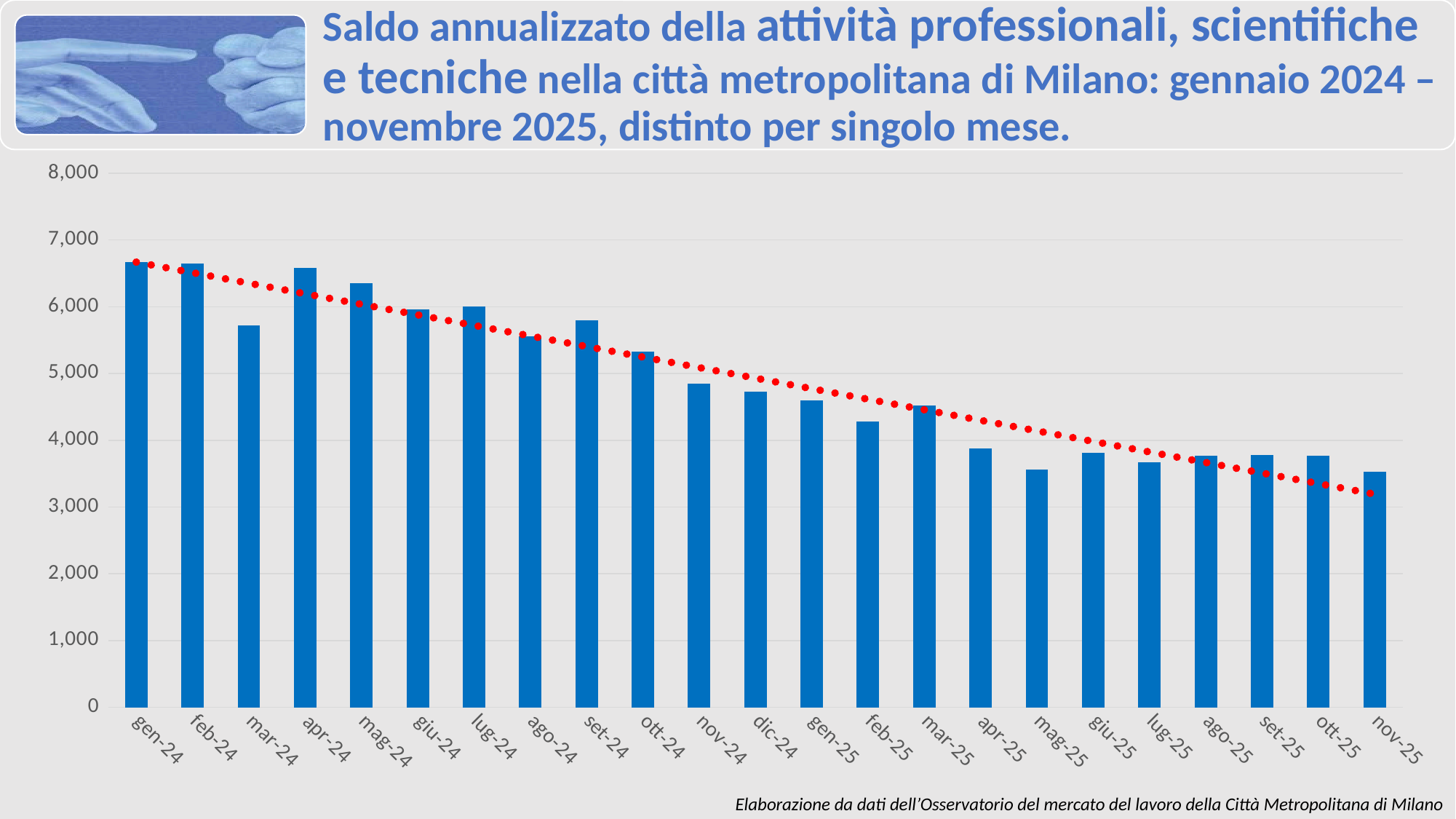
Which has the larger value, mar-24 or apr-24? apr-24 Is the value for apr-25 greater or less than 4,000? less What colour is the dotted trend line drawn over the bars? red Is the value for nov-24 greater or less than 5,000? less Do the bar values generally rise or fall from gen-24 to nov-25? fall How many months (bars) are plotted on the chart? 23 Is the value for feb-25 greater or less than 4,000? greater Which has the larger value, feb-25 or mar-25? mar-25 Which has the larger value, set-24 or ott-24? set-24 What kind of chart is shown on the slide? bar chart